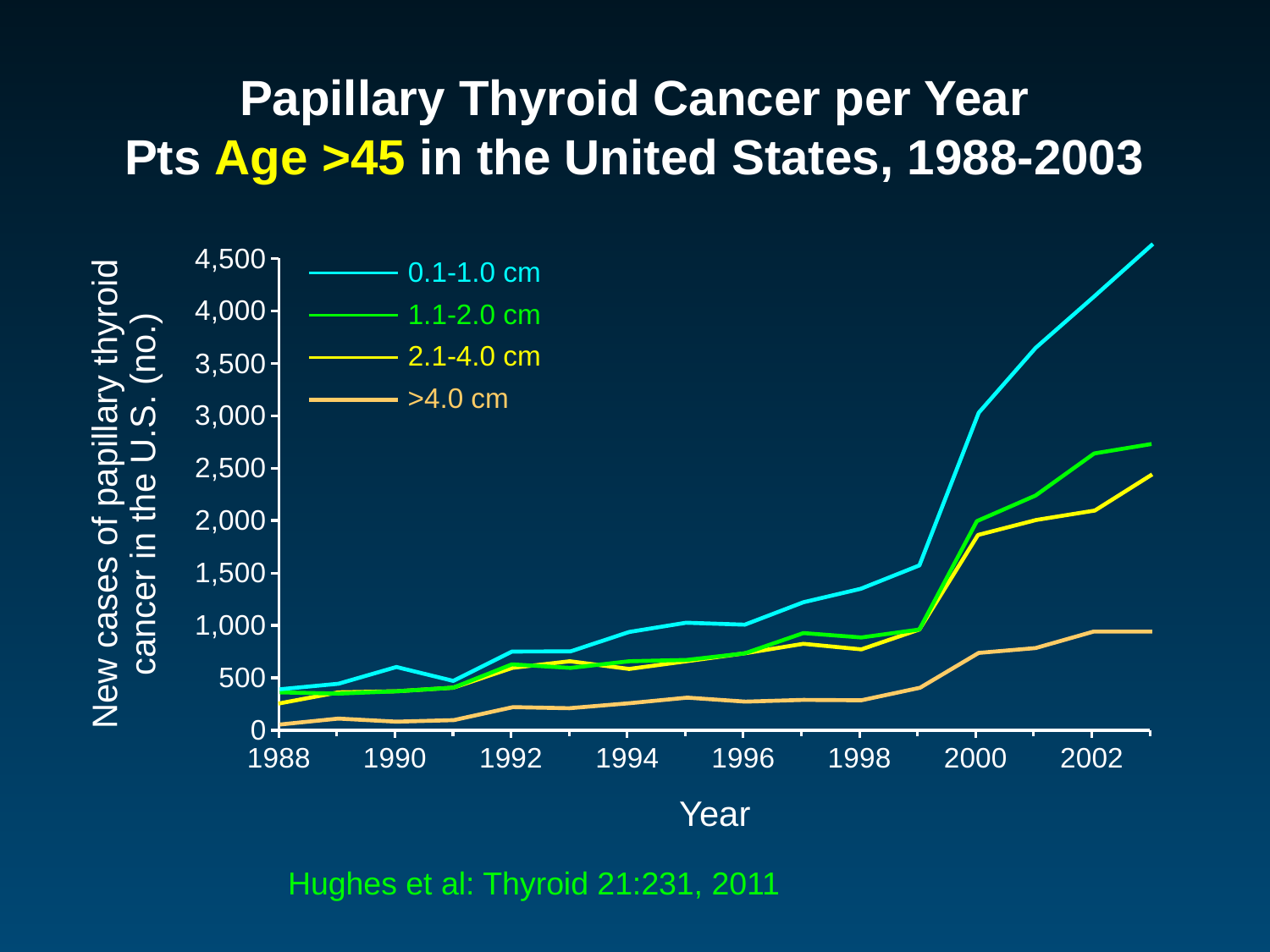
How many series does the legend list? 4 What is the title of the x axis? Year Is the value for the 1.1-2.0 cm series in 2000 greater or less than 1,500? greater Is the value for the >4.0 cm series in 2003 greater or less than 1,500? less Is the value for the 0.1-1.0 cm series in 2003 greater or less than 4,000? greater Does the number of new cases for the 0.1-1.0 cm series rise or fall from 1988 to 2003? rise Which tumor size series has the lowest number of new cases in 2003? >4.0 cm Which tumor size series has the highest number of new cases in 2003? 0.1-1.0 cm What are the four series listed in the legend? 0.1-1.0 cm, 1.1-2.0 cm, 2.1-4.0 cm, >4.0 cm In 2003, which series has more new cases: 1.1-2.0 cm or 2.1-4.0 cm? 1.1-2.0 cm What kind of chart is shown on the slide? line chart